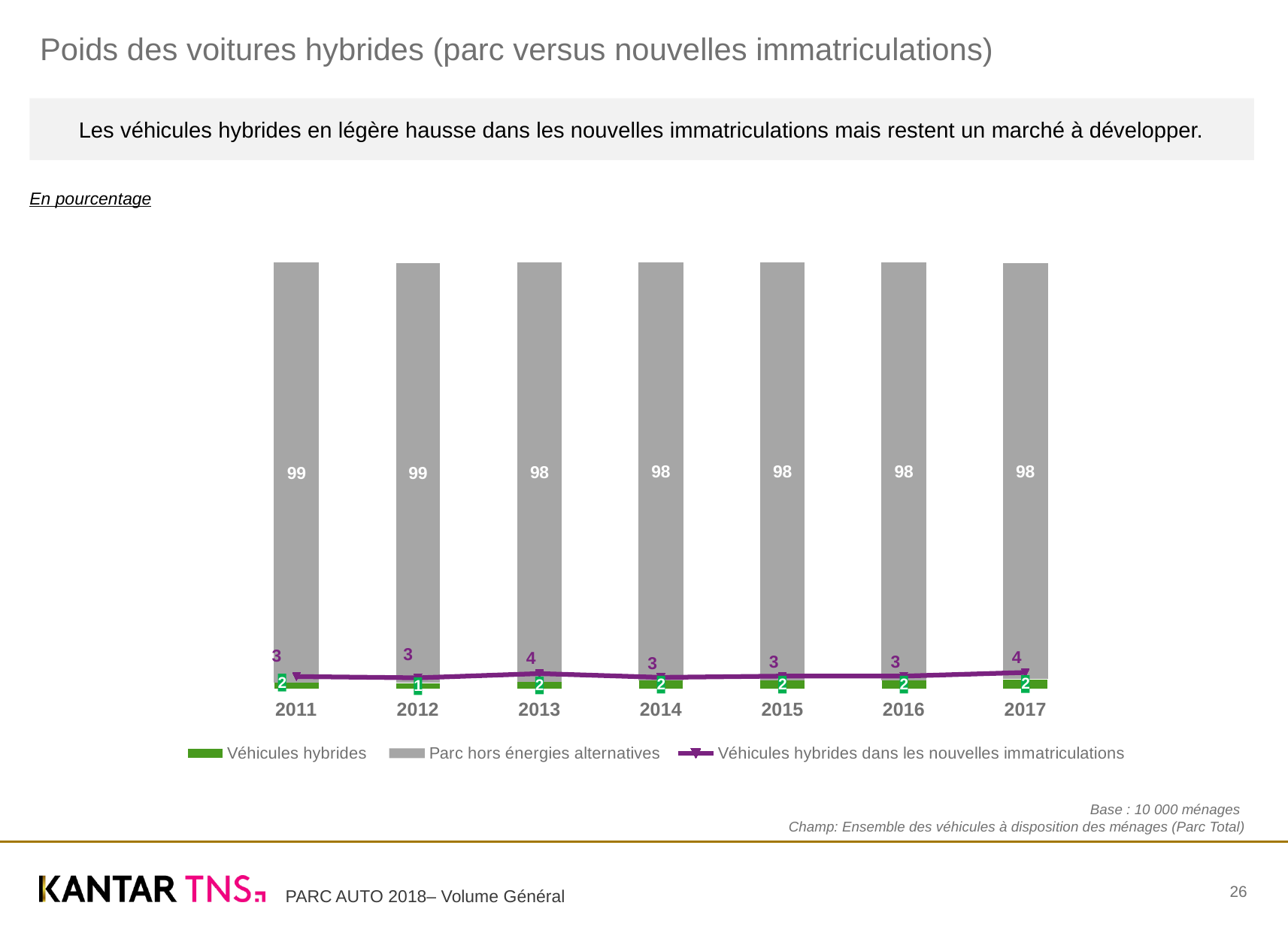
What is the value for Véhicules hybrides in 2012? 1 What is the value for Véhicules hybrides dans les nouvelles immatriculations in 2013? 4 Is the value for Véhicules hybrides dans les nouvelles immatriculations larger in 2013 or in 2014? 2013 Which series is shown in green in the legend? Véhicules hybrides What is the value for Parc hors énergies alternatives in 2017? 98 In which year is the value for Véhicules hybrides the lowest? 2012 What is the value for Parc hors énergies alternatives in 2011? 99 What kind of chart is shown on the slide? Stacked bar chart with a line What is the total of the stacked bar for 2012? 100 How many series does the legend list? 3 What is the difference between the Parc hors énergies alternatives values for 2011 and 2017? 1 How many years are shown on the x axis? 7